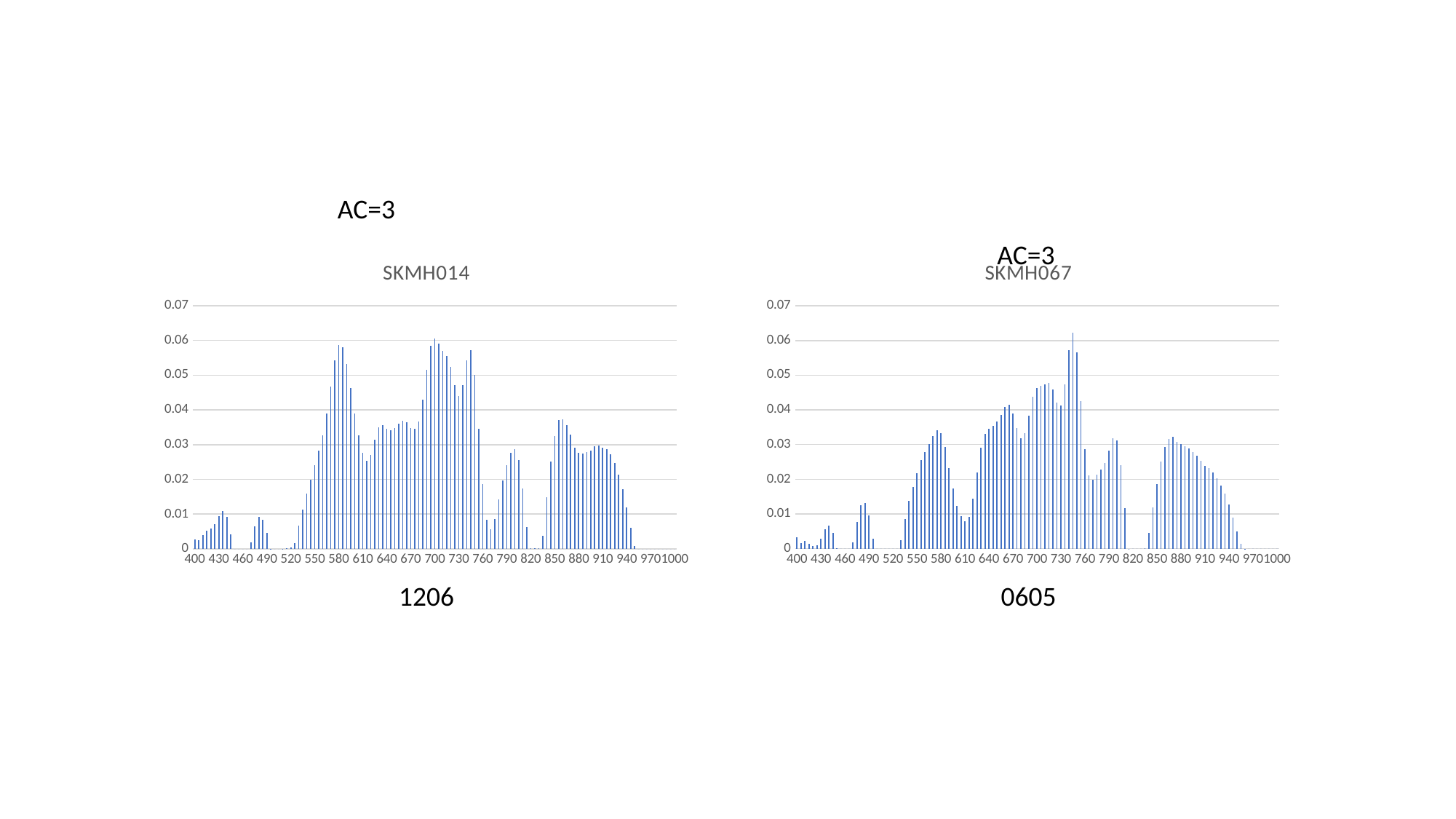
In the SKMH014 chart, is the value at 700 greater or less than 0.05? greater In the SKMH014 chart, is the value at 400 greater or less than 0.01? less In the SKMH067 chart, is the value at 700 greater or less than 0.03? greater What kind of chart is the SKMH067 chart on the right? bar chart What is the highest value shown on the vertical axis of the SKMH067 chart? 0.07 What is the title of the chart on the left side of the slide? SKMH014 What kind of chart is the SKMH014 chart on the left? bar chart